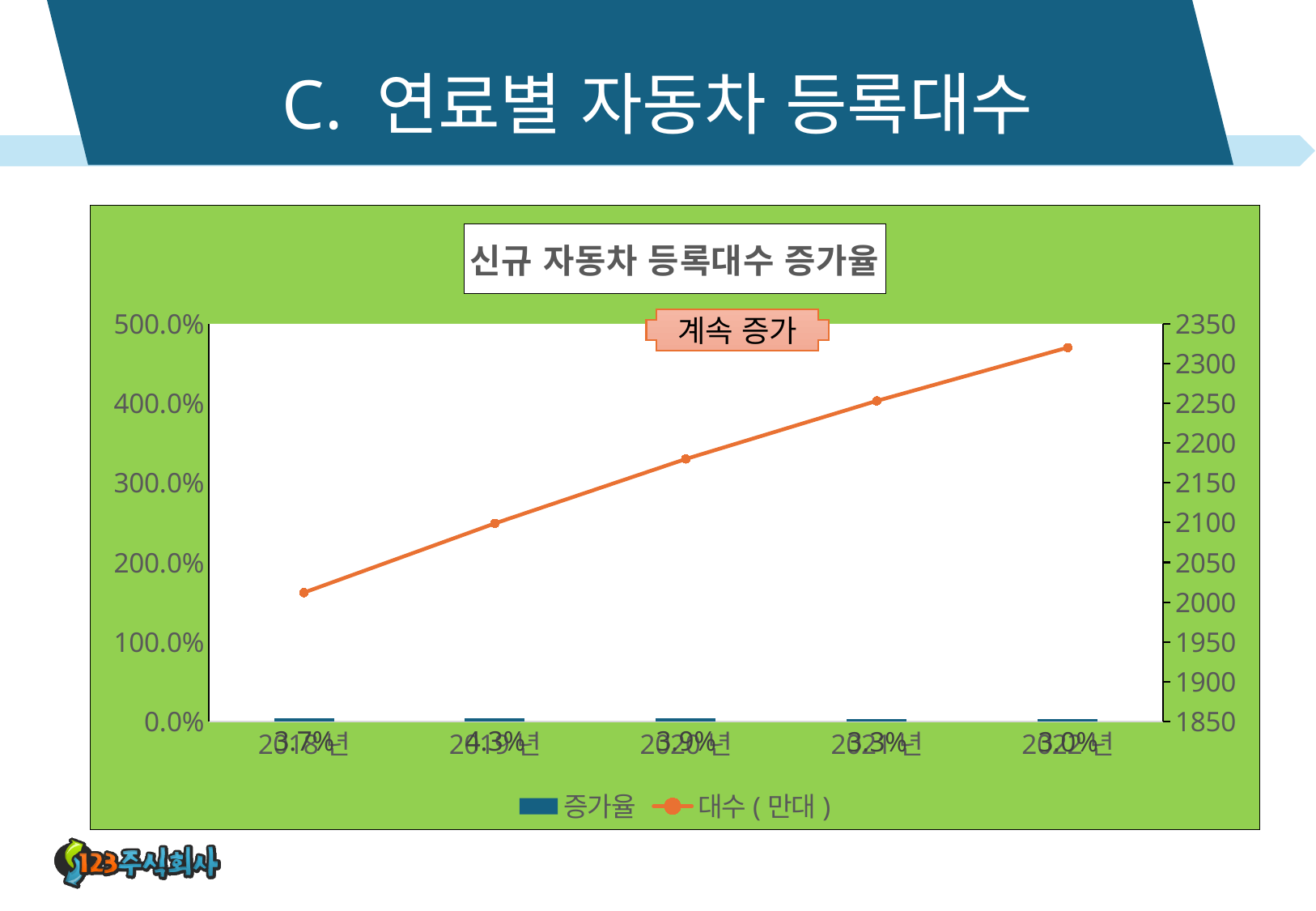
What is the title of the chart? 신규 자동차 등록대수 증가율 What are the two series named in the legend? 증가율 and 대수 ( 만대 ) How many series does the legend list? 2 Which is larger, the 대수 ( 만대 ) value for 2019년 or for 2021년? 2021년 Which year has the highest value for 대수 ( 만대 )? 2022년 Is the 대수 ( 만대 ) value for 2022년 greater or less than 2300? greater Does the 대수 ( 만대 ) line rise or fall from 2018년 to 2022년? Rises What kind of chart is shown on the slide? A combined bar and line chart How many years are shown on the x axis? 5 Which year has the lowest value for 대수 ( 만대 )? 2018년 Is the 대수 ( 만대 ) value for 2018년 greater or less than 2050? less Is the 대수 ( 만대 ) value for 2020년 greater or less than 2150? greater